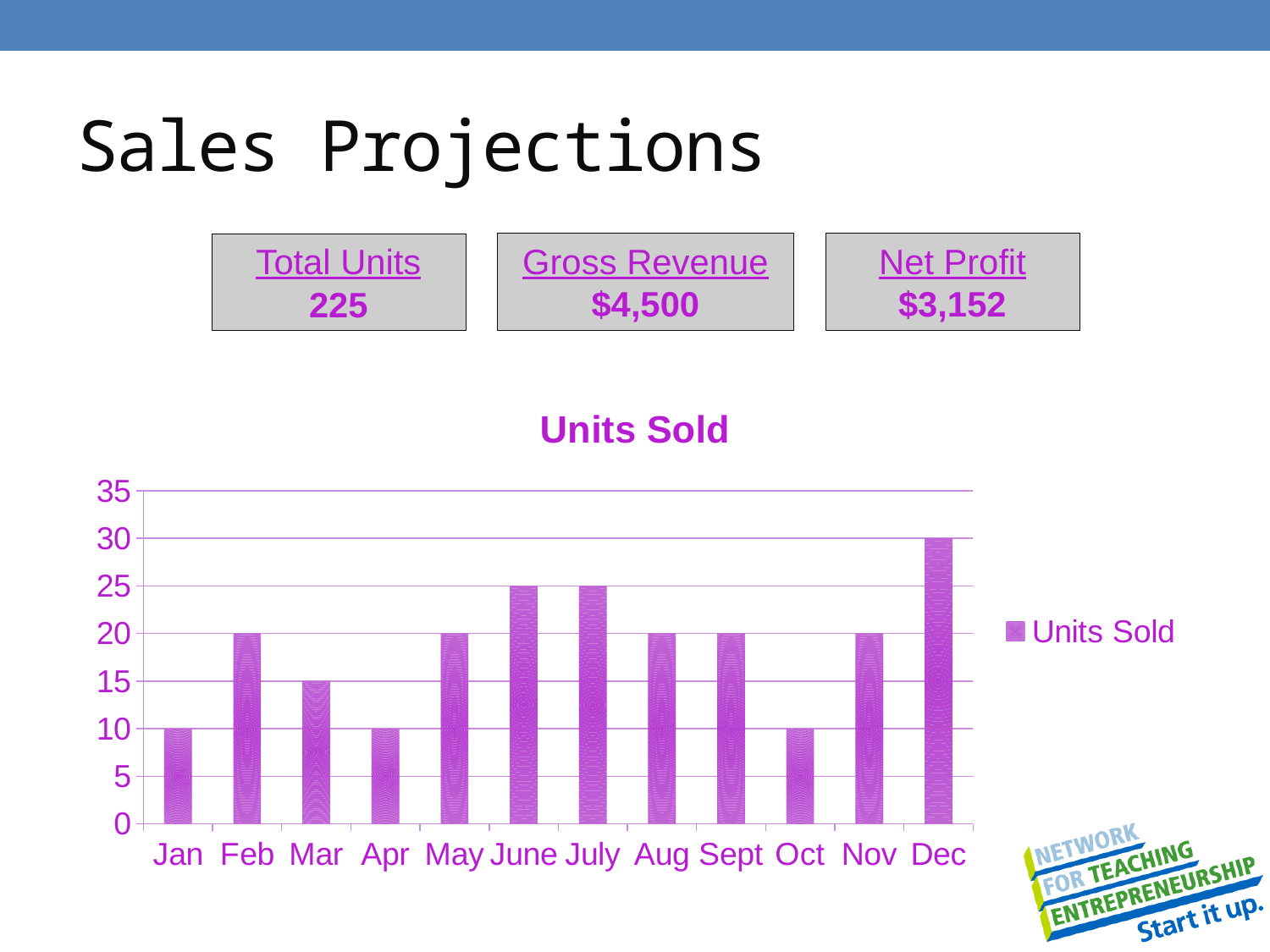
What is the value for Dec in the Units Sold chart? 30 What is the difference between the values for Dec and Jan in the Units Sold chart? 20 Is the value for Oct in the Units Sold chart greater or less than 15? less What is the difference between the values for July and Mar in the Units Sold chart? 10 How many months are shown on the x axis of the Units Sold chart? 12 What is the value for June in the Units Sold chart? 25 Which is larger in the Units Sold chart, the value for Feb or the value for Mar? Feb What is the value for Mar in the Units Sold chart? 15 What kind of chart is the Units Sold chart? bar chart How many series does the legend of the Units Sold chart list? 1 Which month has the highest value in the Units Sold chart? Dec Do the values in the Units Sold chart rise or fall from Sept to Oct? fall